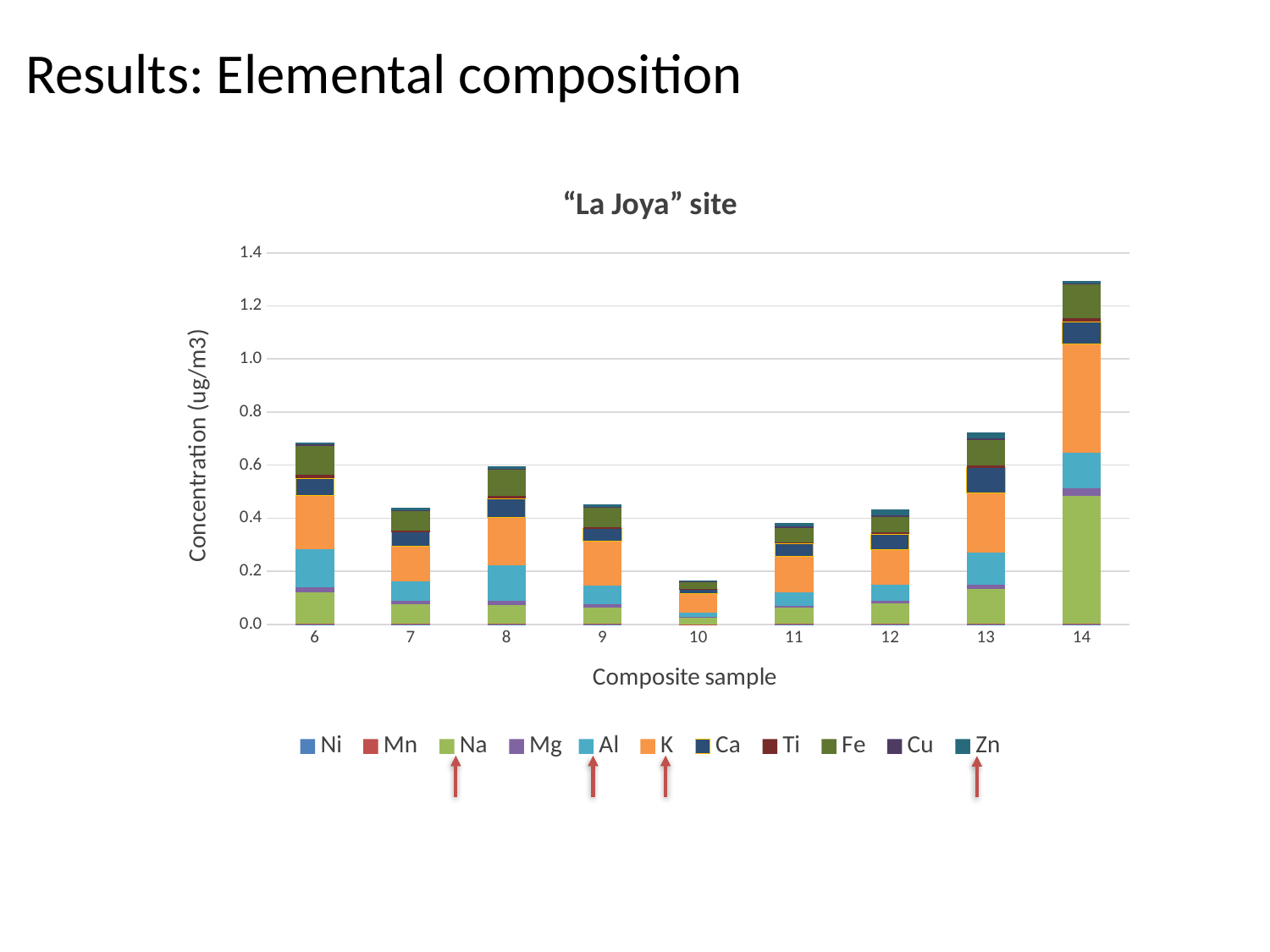
What kind of chart is shown on the slide? Stacked bar chart Is the total concentration for composite sample 11 greater or less than 0.4? less How many composite samples are plotted along the x axis? 9 Which has a larger total concentration, composite sample 6 or composite sample 7? 6 Which composite sample has the lowest total concentration? 10 Is the total concentration for composite sample 14 greater or less than 1.2? greater How many series does the legend list? 11 Which composite sample has the highest total concentration? 14 Which has a larger total concentration, composite sample 8 or composite sample 13? 13 Is the total concentration for composite sample 10 greater or less than 0.2? less What is the title of the chart? "La Joya" site